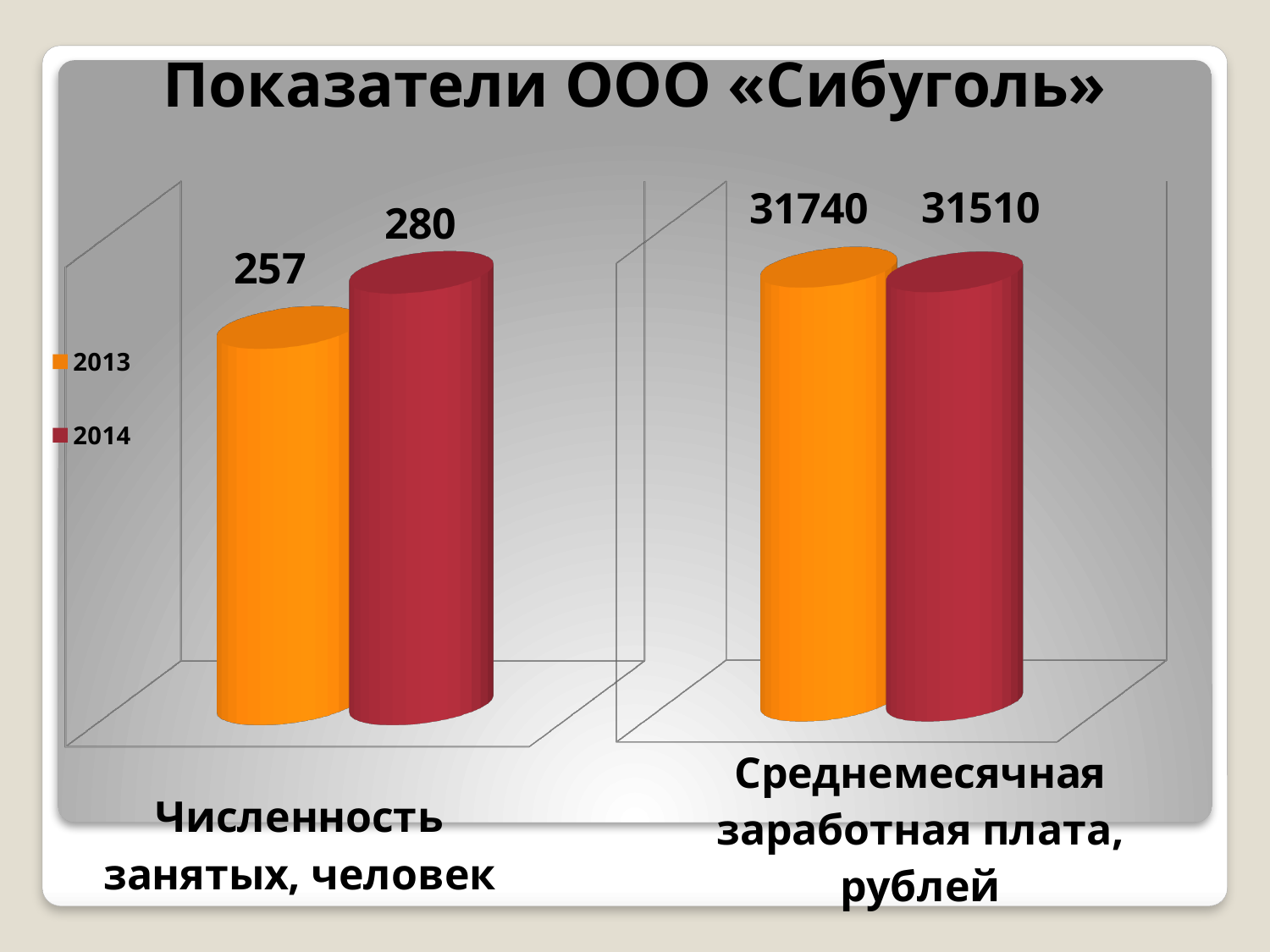
On the left chart (Численность занятых, человек), what is the value for 2014? 280 How many series does the legend list? 2 On the left chart (Численность занятых, человек), what is the difference between the 2014 and 2013 values? 23 What kind of chart is shown on the slide? bar chart On the left chart (Численность занятых, человек), what is the value for 2013? 257 On the left chart (Численность занятых, человек), which year has the higher value? 2014